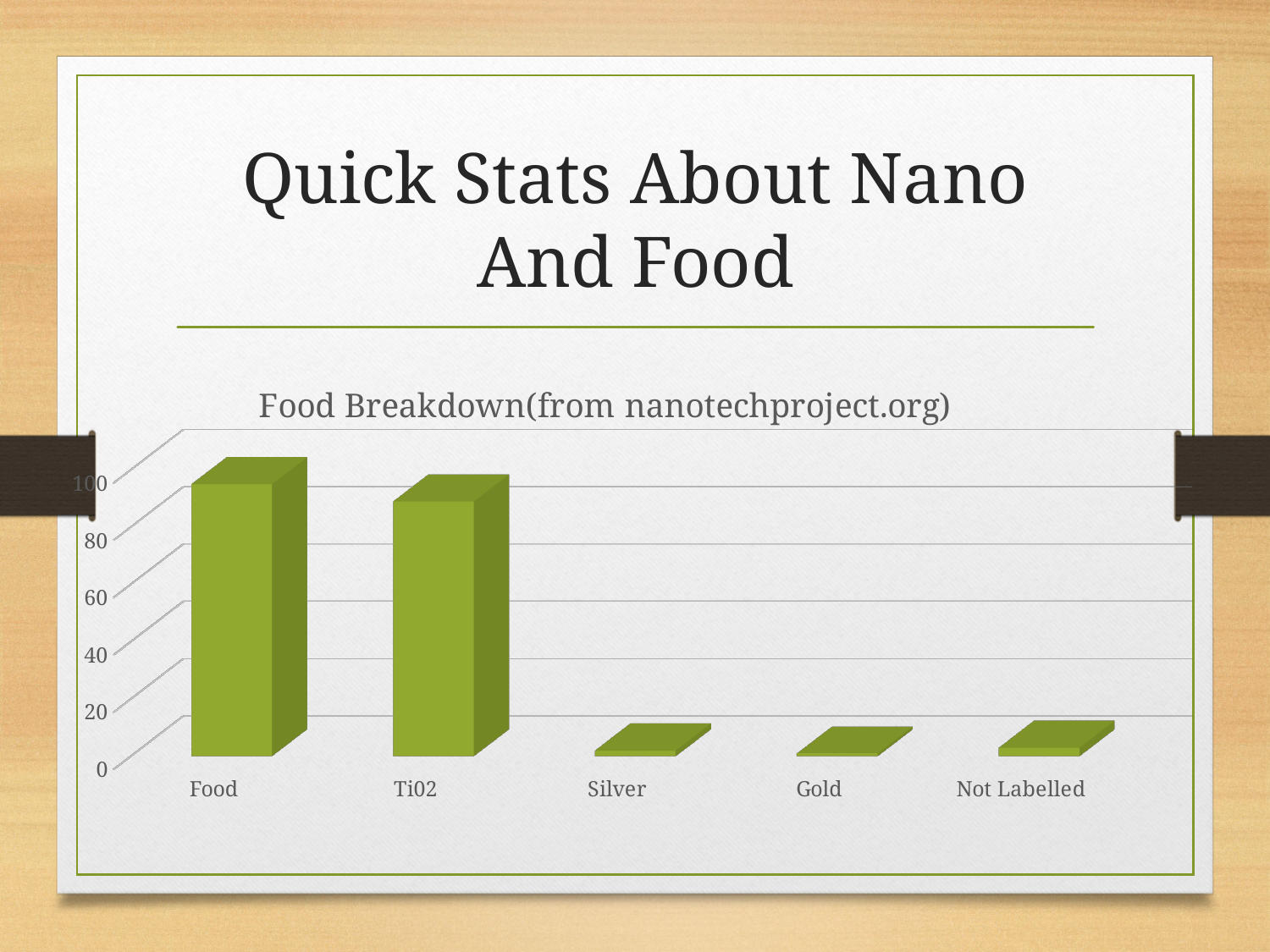
Do the values generally rise or fall from left to right along the x axis? fall Is the value for Ti02 greater or less than 60? greater Is the value for Silver greater or less than 20? less Which is larger, the value for Ti02 or the value for Gold? Ti02 Which is larger, the value for Food or the value for Ti02? Food Is the value for Gold greater or less than 20? less How many categories are shown on the x axis of the chart? 5 What kind of chart is shown on the slide? bar chart What is the title of the chart? Food Breakdown(from nanotechproject.org) Which category has the highest value in the chart? Food